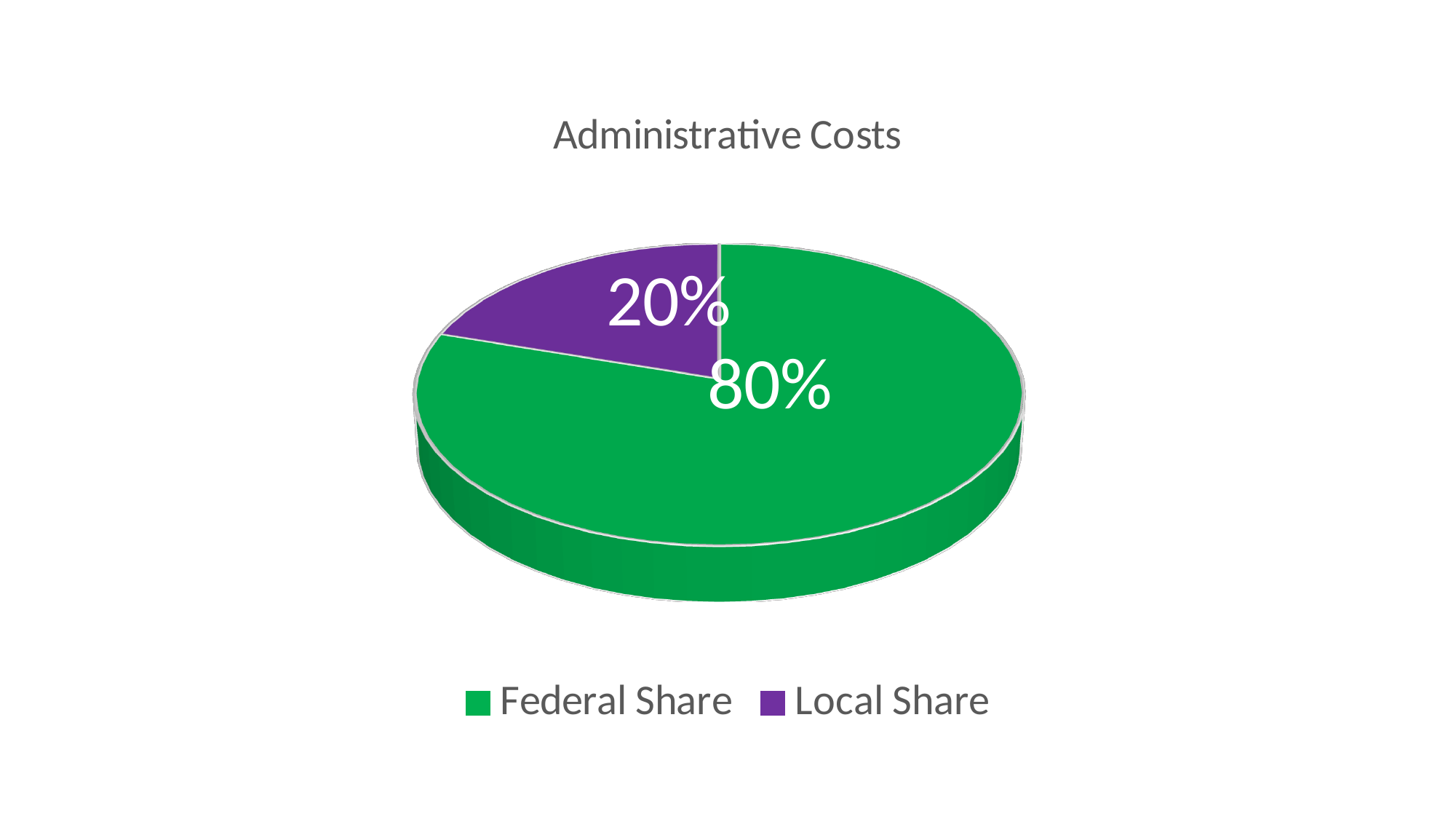
What is the title of the chart? Administrative Costs What kind of chart is shown on the slide? pie chart Which slice is the smallest? Local Share How many entries does the legend list? 2 What is the difference between the Federal Share and the Local Share? 60% What colour is the Local Share slice? purple What share of administrative costs is the Federal Share? 80% Which is larger, the Federal Share or the Local Share? Federal Share Which slice is the largest? Federal Share How many slices does the pie chart have? 2 What share of administrative costs is the Local Share? 20%